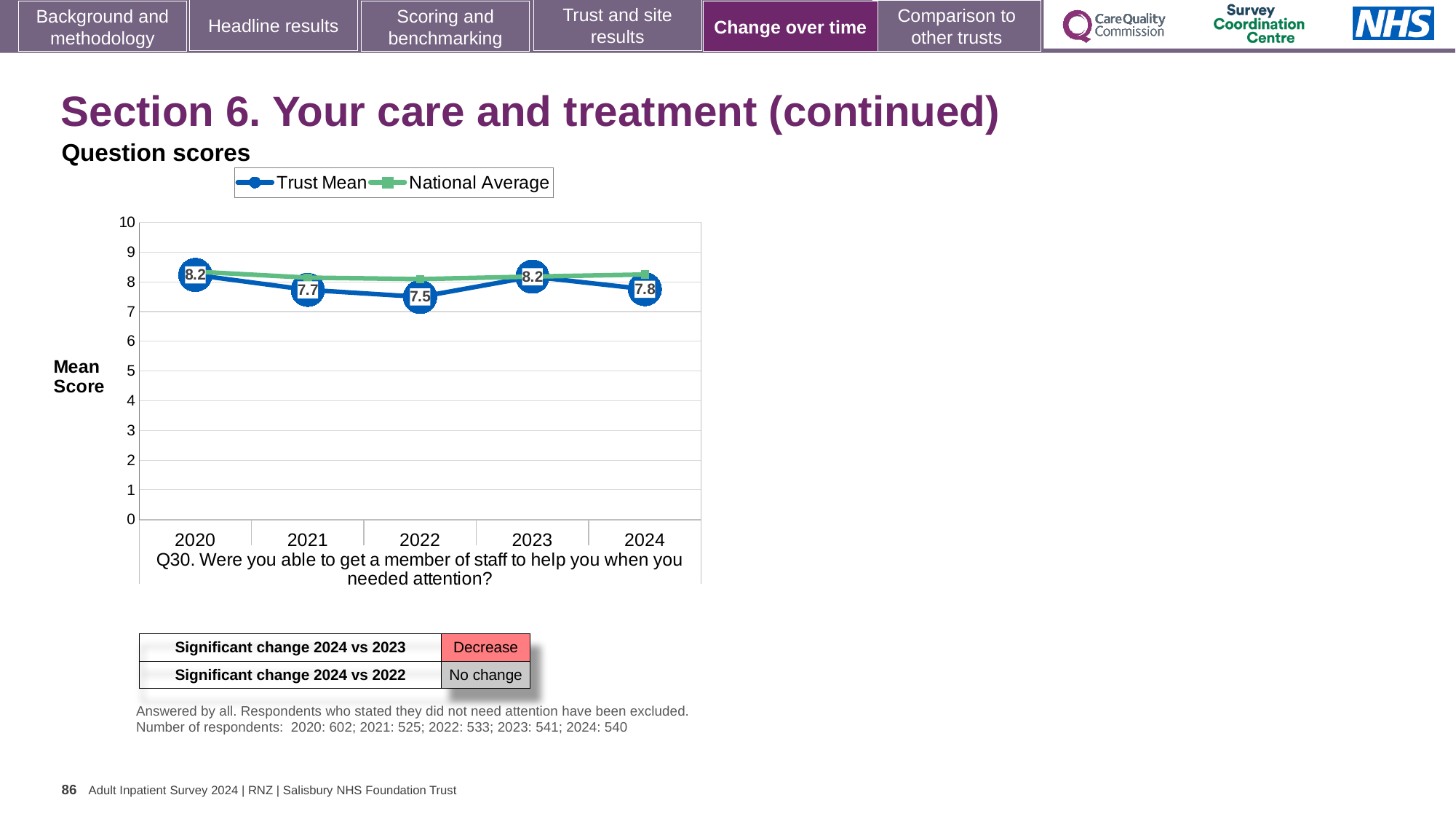
What is the Trust Mean score for 2024? 7.8 Does the Trust Mean score rise or fall from 2023 to 2024? Fall What is the Trust Mean score for 2021? 7.7 What is the Trust Mean score for 2022? 7.5 What is the difference between the Trust Mean scores for 2023 and 2024? 0.4 In which year is the Trust Mean score lowest? 2022 What kind of chart is shown on the slide? Line chart Is the National Average value for 2022 greater or less than 7? greater How many years are shown on the x axis? 5 How many series does the legend list? 2 What is the difference between the Trust Mean scores for 2020 and 2022? 0.7 Which is larger, the Trust Mean score for 2021 or for 2023? 2023